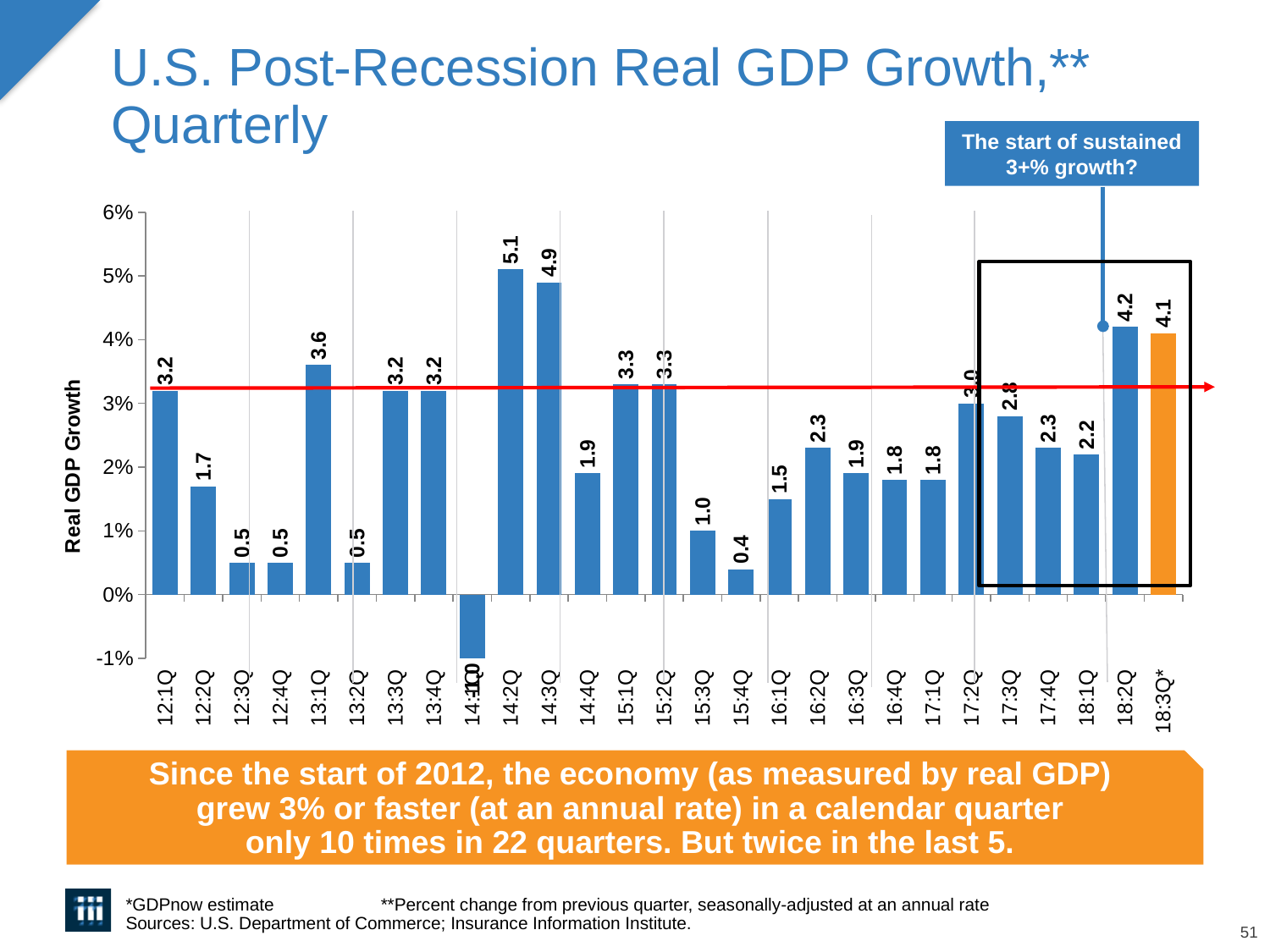
What is the difference between the values for 18:2Q and 18:1Q? 2.0 How many quarters (bars) are plotted in the chart? 27 What kind of chart is shown on the slide? bar chart What is the real GDP growth value shown for 14:2Q? 5.1 Which quarter has the highest real GDP growth in the chart? 14:2Q What is the difference between the values for 14:3Q and 14:4Q? 3.0 What is the value shown for 18:3Q*? 4.1 Which quarter has the larger value, 13:1Q or 13:3Q? 13:1Q Which quarter's bar is coloured orange instead of blue? 18:3Q* What is the real GDP growth value shown for 16:2Q? 2.3 Is the value for 15:4Q greater or less than 1%? less Which quarter has the lowest real GDP growth in the chart? 14:1Q